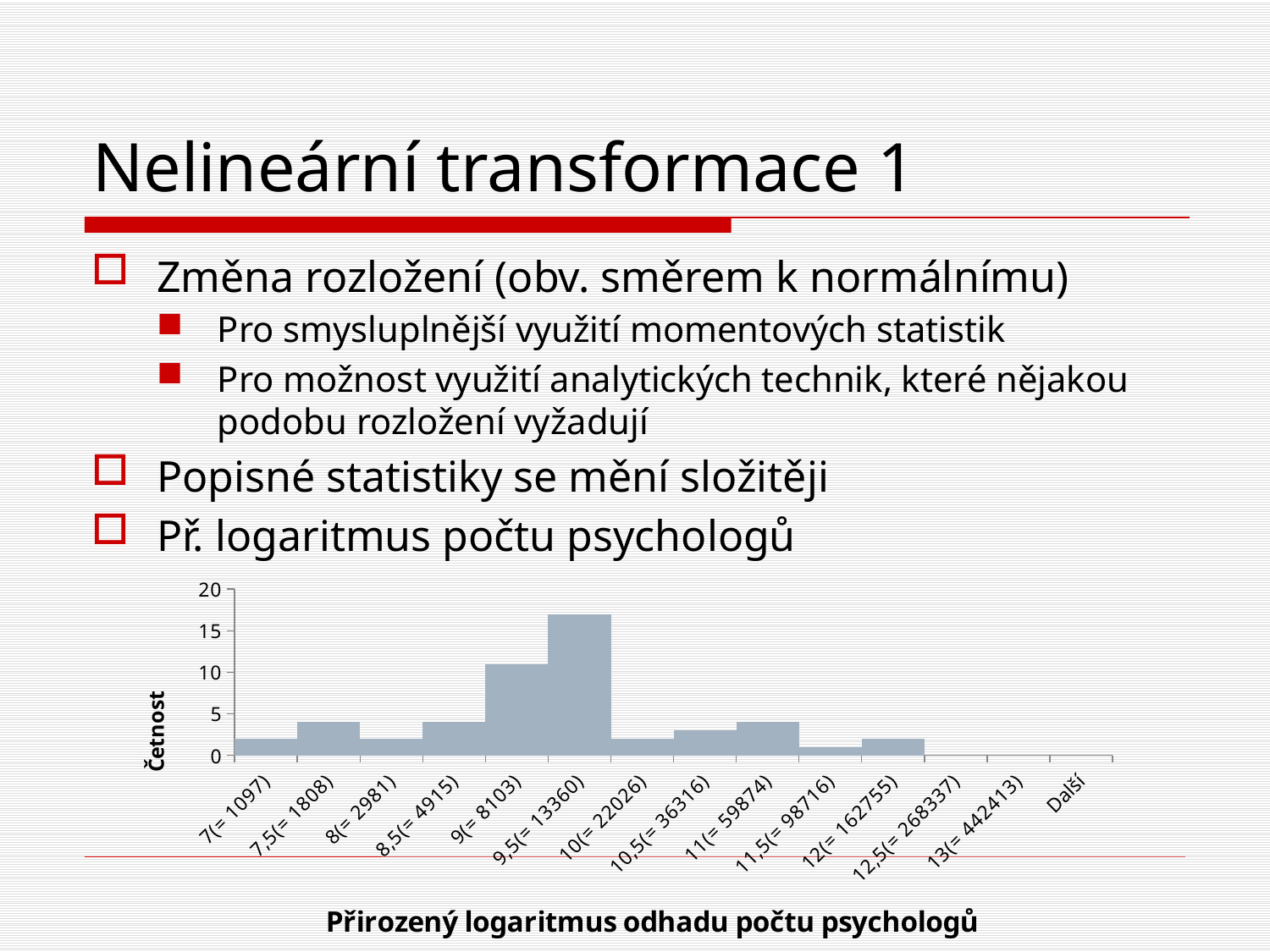
Is the value for 10(= 22026) greater or less than 5? less Is the value for 9(= 8103) greater or less than 10? greater What is the label of the vertical axis of the chart? Četnost What is the label of the horizontal axis of the chart? Přirozený logaritmus odhadu počtu psychologů Is the value for 11(= 59874) greater or less than 10? less How many categories are shown on the x axis of the chart? 14 Which is larger, the value for 9,5(= 13360) or the value for 9(= 8103)? 9,5(= 13360) Which is larger, the value for 9(= 8103) or the value for 10(= 22026)? 9(= 8103) What kind of chart is shown on the slide? bar chart Which category has the highest frequency (Četnost) in the chart? 9,5(= 13360)